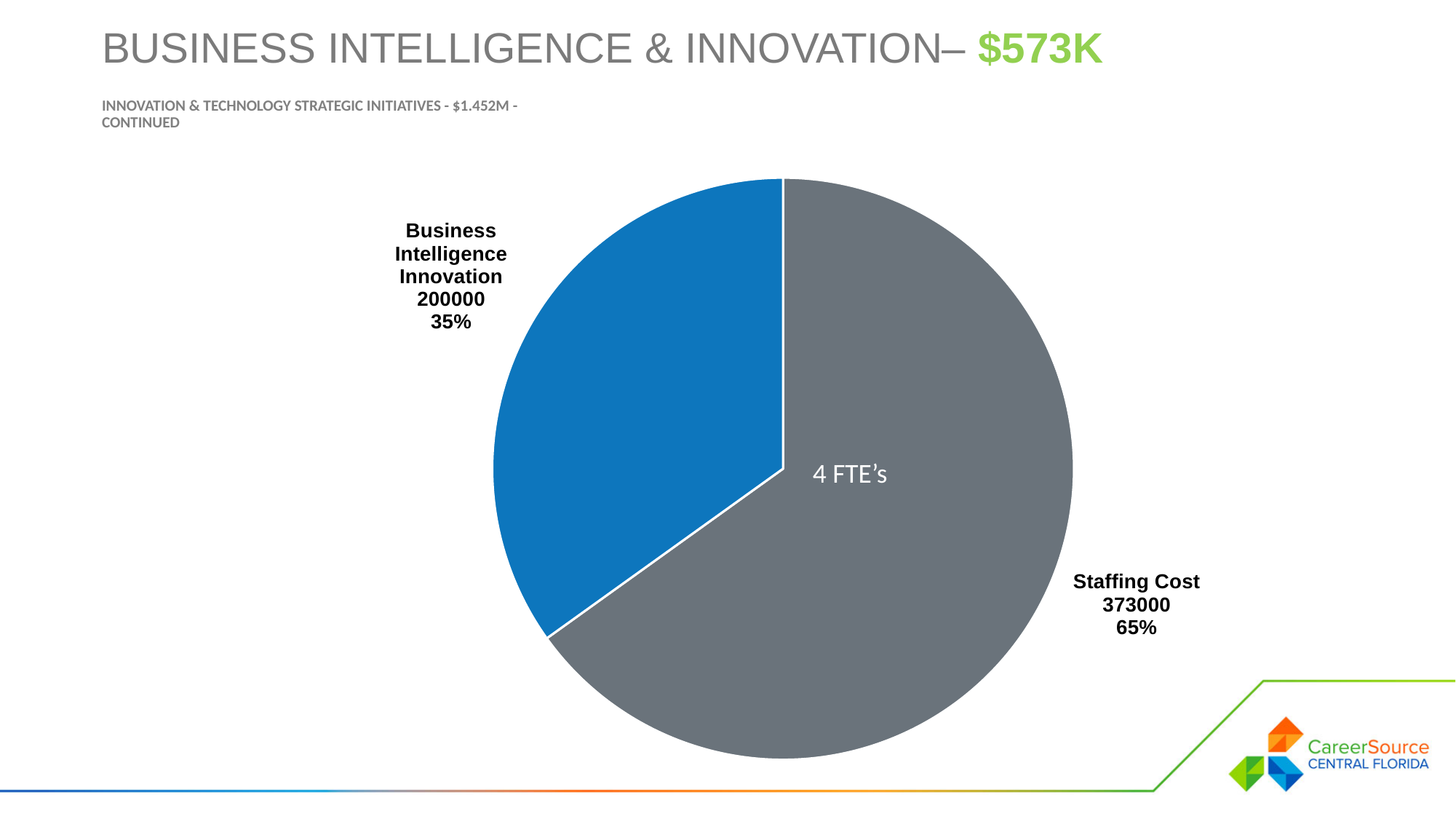
How many slices does the pie chart have? 2 Which slice is the smallest? Business Intelligence Innovation What share of the pie does Business Intelligence Innovation represent? 35% What text is printed inside the Staffing Cost slice? 4 FTE's Which slice is the largest? Staffing Cost What colour is the Business Intelligence Innovation slice? blue What type of chart is shown on the slide? pie chart What is the difference between the Staffing Cost value and the Business Intelligence Innovation value? 173000 What is the value shown for Business Intelligence Innovation? 200000 What share of the pie does Staffing Cost represent? 65% What is the value shown for Staffing Cost? 373000 Which is larger, Staffing Cost or Business Intelligence Innovation? Staffing Cost